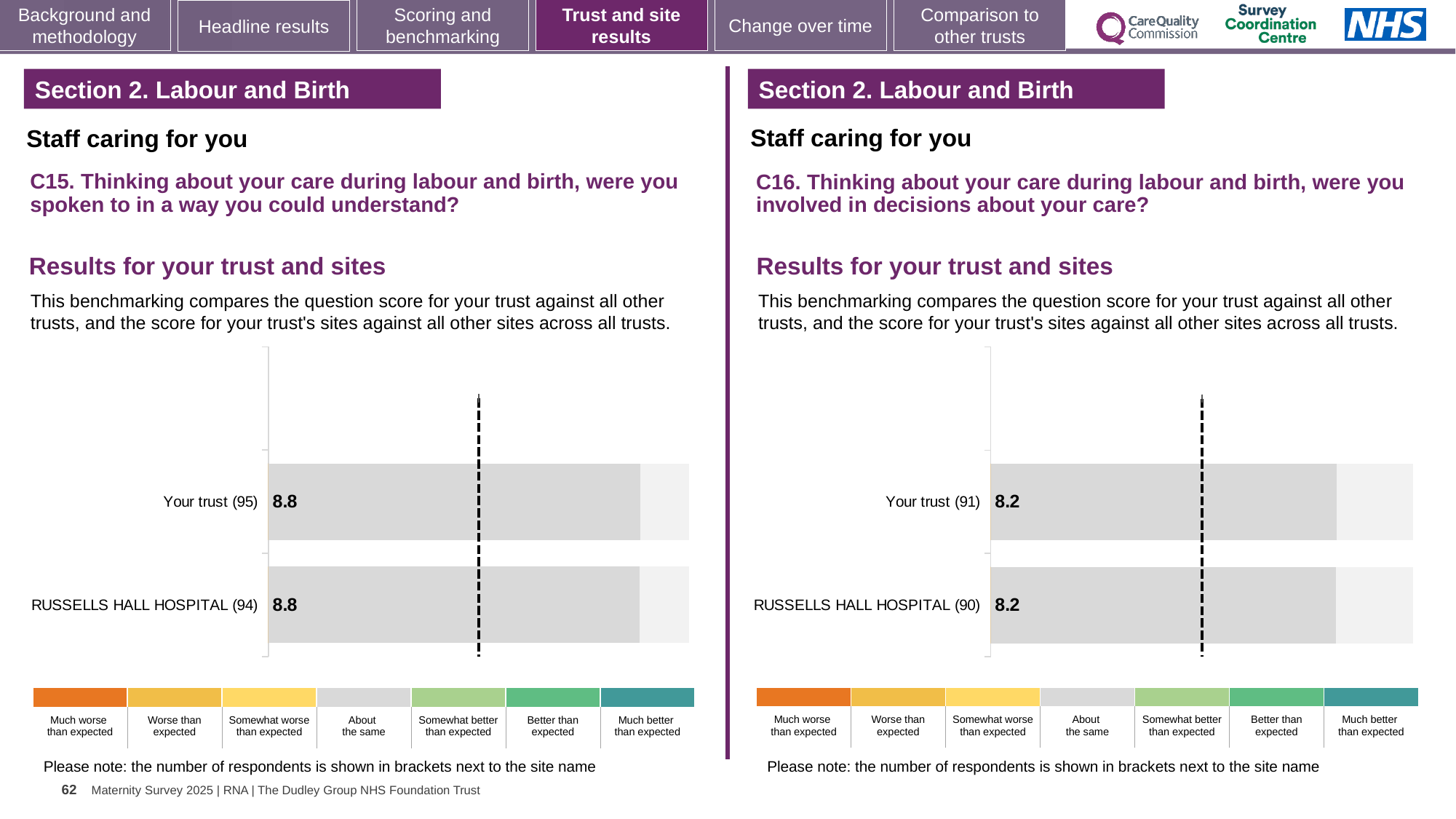
How many bars are plotted in the C15 chart on the left? 2 In the C15 chart on the left, how many respondents are shown in brackets for Your trust? 95 In the C16 chart on the right, what is the score for Your trust? 8.2 In the C16 chart on the right, how many respondents are shown in brackets for RUSSELLS HALL HOSPITAL? 90 How many bars are plotted in the C16 chart on the right? 2 In the C16 chart on the right, what is the score for RUSSELLS HALL HOSPITAL? 8.2 In the C15 chart on the left, what is the difference between the Your trust score and the RUSSELLS HALL HOSPITAL score? 0.0 In the C16 chart on the right, which benchmark category does the grey colour of the bars correspond to in the legend? About the same In the C15 chart on the left, what is the score for Your trust? 8.8 In the C15 chart on the left, what is the score for RUSSELLS HALL HOSPITAL? 8.8 In the C16 chart on the right, what is the difference between the Your trust score and the RUSSELLS HALL HOSPITAL score? 0.0 What kind of chart is used for the C15 results on the left? Bar chart